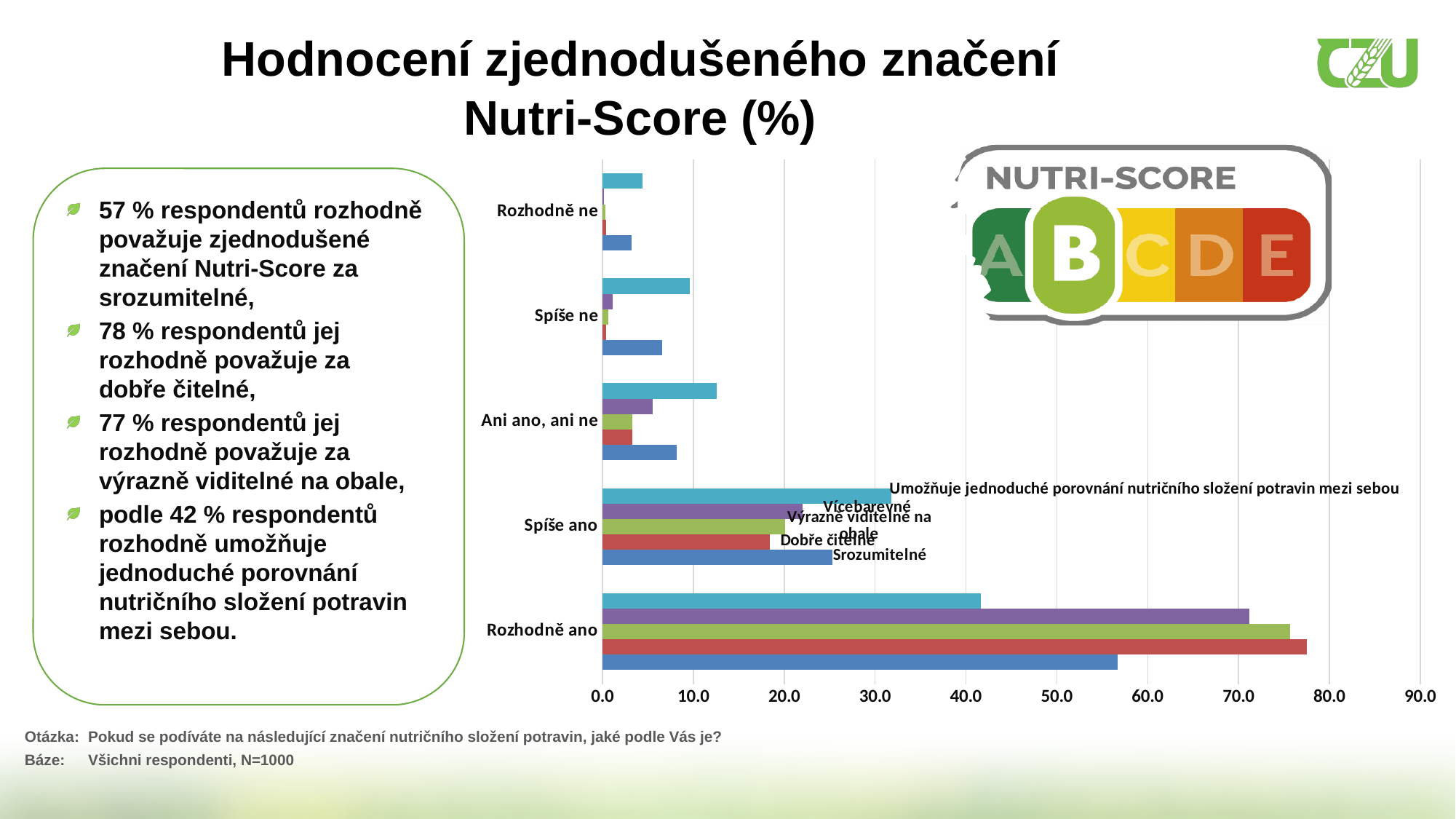
Is the value for 'Srozumitelné' in the 'Rozhodně ne' category greater or less than 10.0? less How many response categories are shown on the y axis of the chart? 5 Which category has the highest value for the 'Vícebarevné' series? Rozhodně ano Is the value for 'Srozumitelné' in the 'Spíše ano' category greater or less than 20.0? greater Which series has the lowest value in the 'Rozhodně ano' category? Umožňuje jednoduché porovnání nutričního složení potravin mezi sebou Is the value for 'Srozumitelné' in the 'Rozhodně ano' category greater or less than 50.0? greater Which series has the highest value in the 'Rozhodně ano' category? Dobře čitelné In the 'Rozhodně ano' category, which is larger: the value for 'Dobře čitelné' or the value for 'Srozumitelné'? Dobře čitelné How many series does the chart's legend list? 5 What is the highest value shown on the chart's x axis? 90.0 What kind of chart is shown on the slide? bar chart